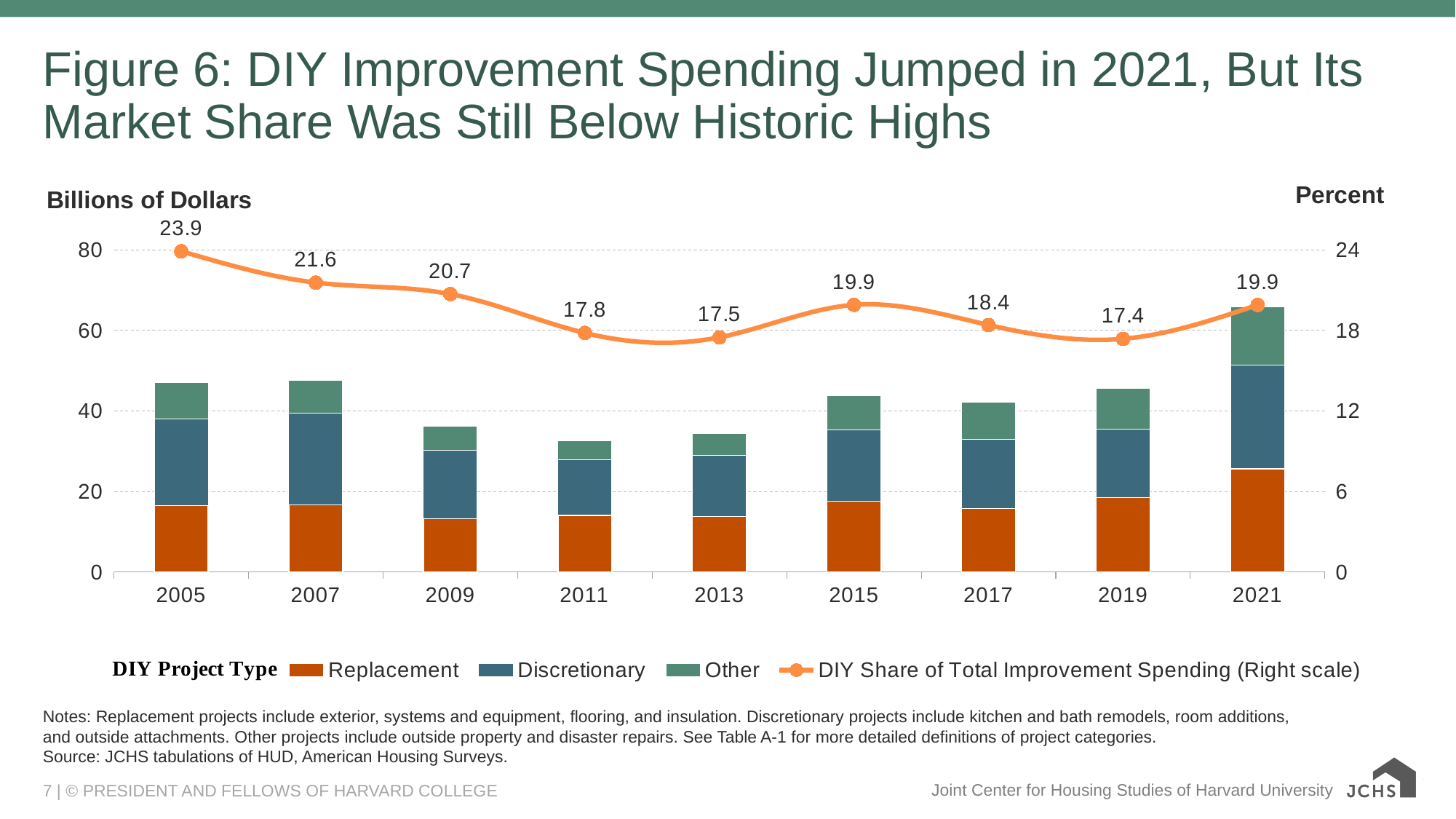
Does the DIY Share of Total Improvement Spending rise or fall from 2005 to 2011? fall In which year is the DIY Share of Total Improvement Spending highest? 2005 In which year is the DIY Share of Total Improvement Spending lowest? 2019 How many years are shown on the x axis? 9 What is the difference between the DIY Share of Total Improvement Spending in 2005 and in 2021? 4.0 What is the DIY Share of Total Improvement Spending in 2005? 23.9 How many series does the legend list? 4 Is the total height of the stacked bar for 2011 greater or less than 40 billion dollars? less What kind of chart is this? Stacked bar chart with a line Is the total height of the stacked bar for 2021 greater or less than 60 billion dollars? greater What is the DIY Share of Total Improvement Spending in 2019? 17.4 Which year has a larger DIY Share of Total Improvement Spending, 2007 or 2015? 2007